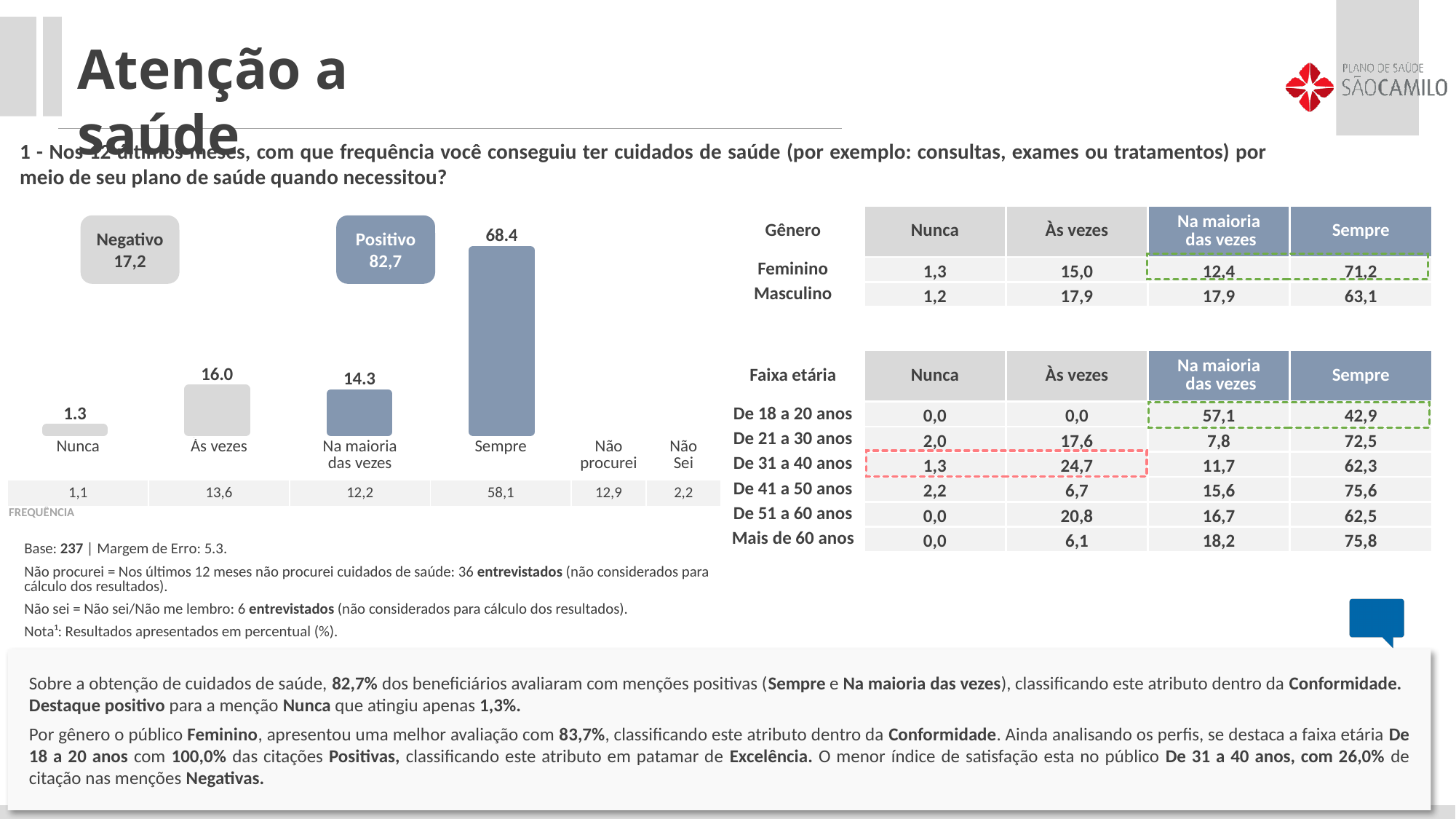
What is the value of the bar for 'Na maioria das vezes' in the bar chart? 14.3 Which category has the lowest bar in the bar chart? Nunca Which category has the highest bar in the bar chart? Sempre What value is shown in the 'Positivo' box above the bar chart? 82,7 How many bars are plotted in the bar chart? 4 What is the difference between the bar values for 'Às vezes' and 'Na maioria das vezes' in the bar chart? 1.7 What is the difference between the bar values for 'Sempre' and 'Às vezes' in the bar chart? 52.4 What is the value of the bar for 'Sempre' in the bar chart? 68.4 In the bar chart, which bar is taller: 'Às vezes' or 'Na maioria das vezes'? Às vezes What is the value of the bar for 'Nunca' in the bar chart? 1.3 What is the value of the bar for 'Às vezes' in the bar chart? 16.0 What kind of chart is shown on the left of the slide? Bar chart